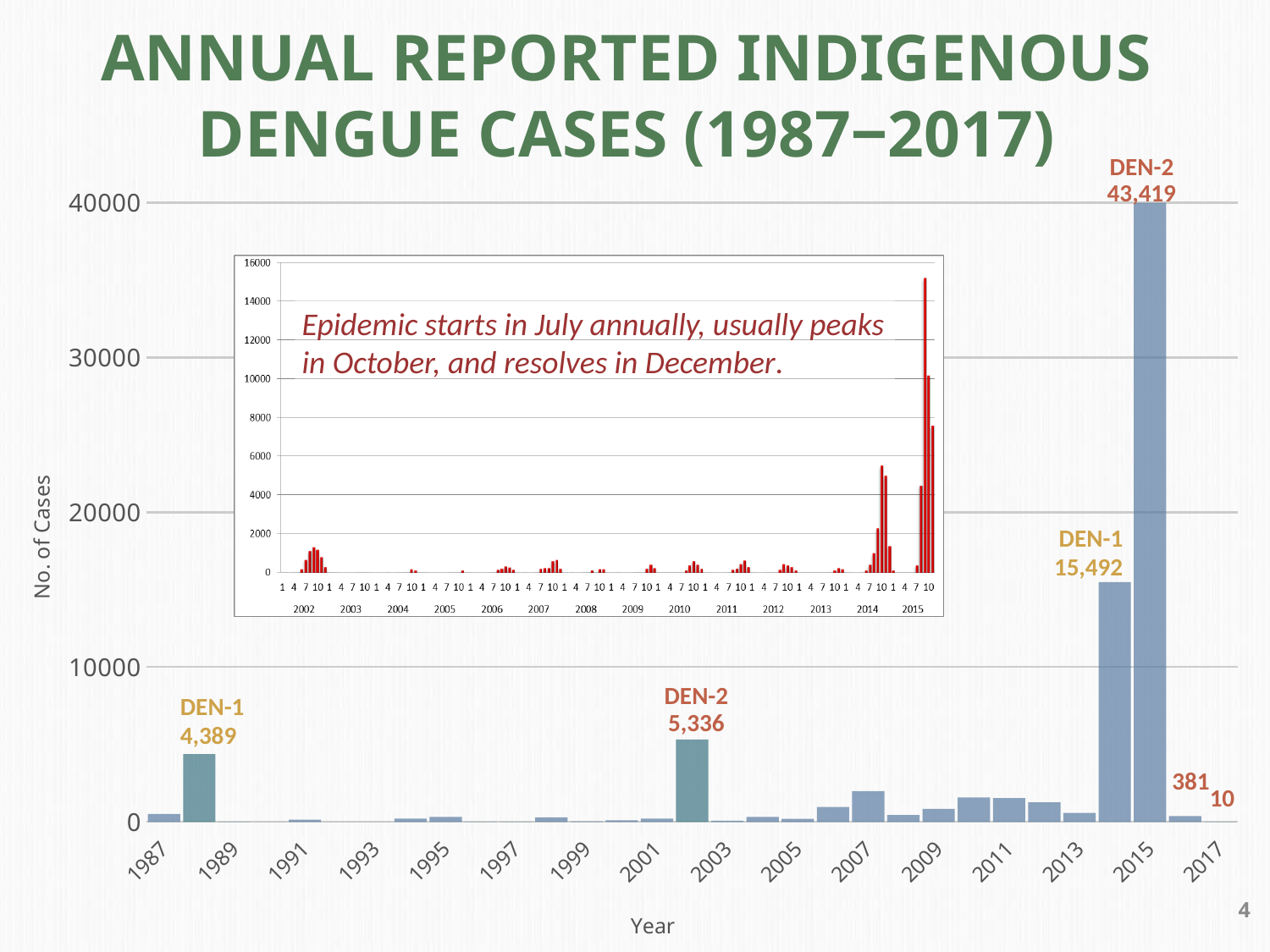
In the main chart, which year had more cases, 2002 or 1988? 2002 In the main chart, what is the number of cases labelled for 1988? 4,389 In the main chart, what is the number of cases labelled for 2002? 5,336 In the main chart, what is the difference between the 2015 and 2014 case counts? 27,927 In the inset chart, is the tallest bar in 2015 greater or less than 14000? greater In the main chart, how many indigenous dengue cases were reported in 2015? 43,419 In the main chart, how many cases were reported in 2014? 15,492 In the main chart, which year has the highest number of reported cases? 2015 In the main chart, how many cases were reported in 2017? 10 What is the y-axis label of the main chart? No. of Cases In the main chart, is the value for 2007 greater or less than 10000? less What kind of chart is the main chart on the slide? Bar chart